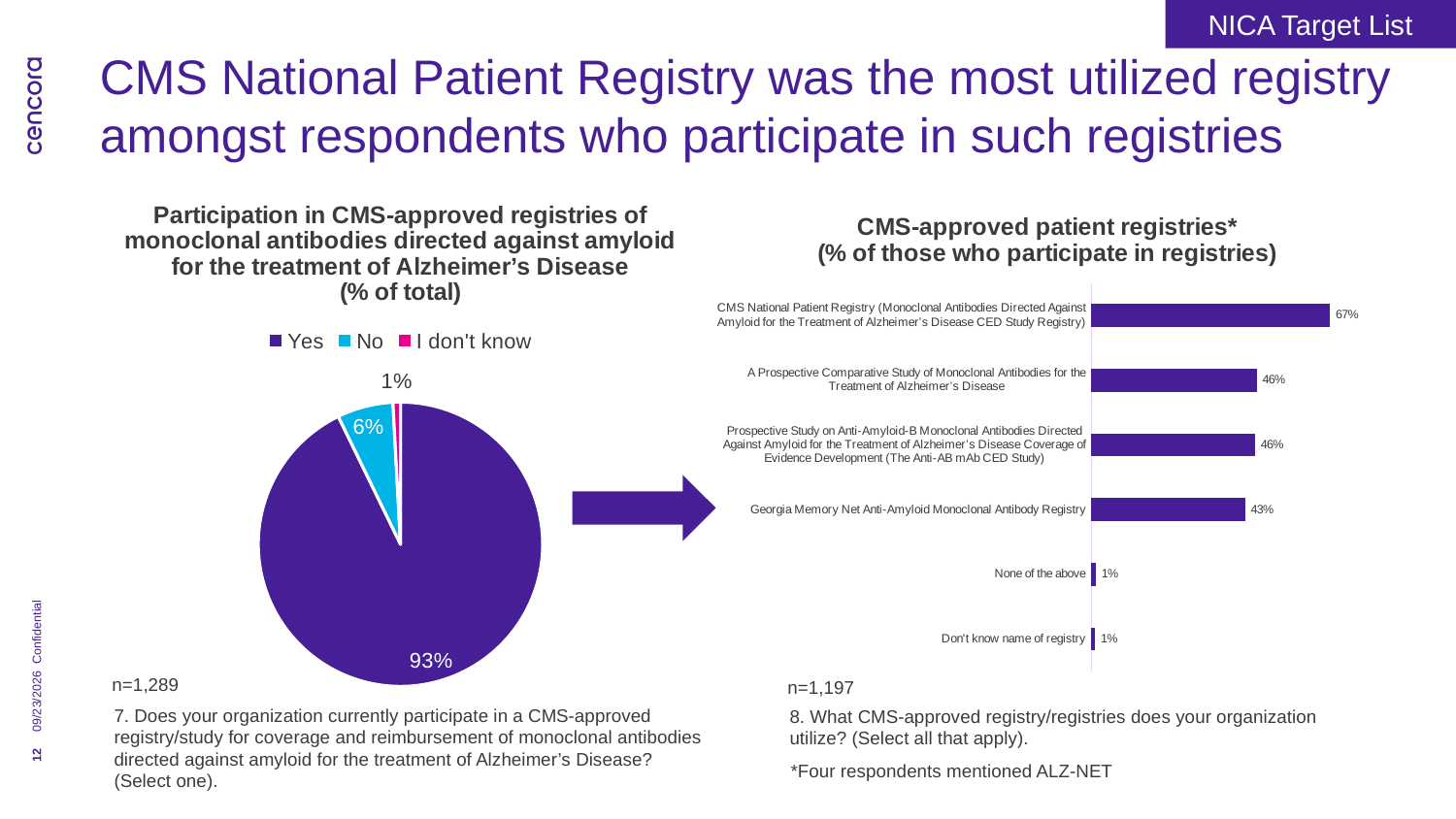
In the pie chart on the left, how many entries does the legend list? 3 In the pie chart on the left, what percentage of respondents answered "No"? 6% In the "CMS-approved patient registries" chart, how many categories are shown? 6 In the pie chart on the left, what percentage of respondents answered "Yes"? 93% In the pie chart on the left, what percentage of respondents answered "I don't know"? 1% What type of chart is the "CMS-approved patient registries" chart on the right? Bar chart In the "CMS-approved patient registries" chart, which registry has the highest value? CMS National Patient Registry What type of chart is shown on the left side of the slide? Pie chart In the "CMS-approved patient registries" chart, what is the value for the Georgia Memory Net Anti-Amyloid Monoclonal Antibody Registry? 43% In the pie chart on the left, what is the difference between the "Yes" and "No" shares? 87% In the "CMS-approved patient registries" chart, what is the difference between the CMS National Patient Registry and the Georgia Memory Net registry values? 24% In the "CMS-approved patient registries" chart, what is the value for the CMS National Patient Registry? 67%